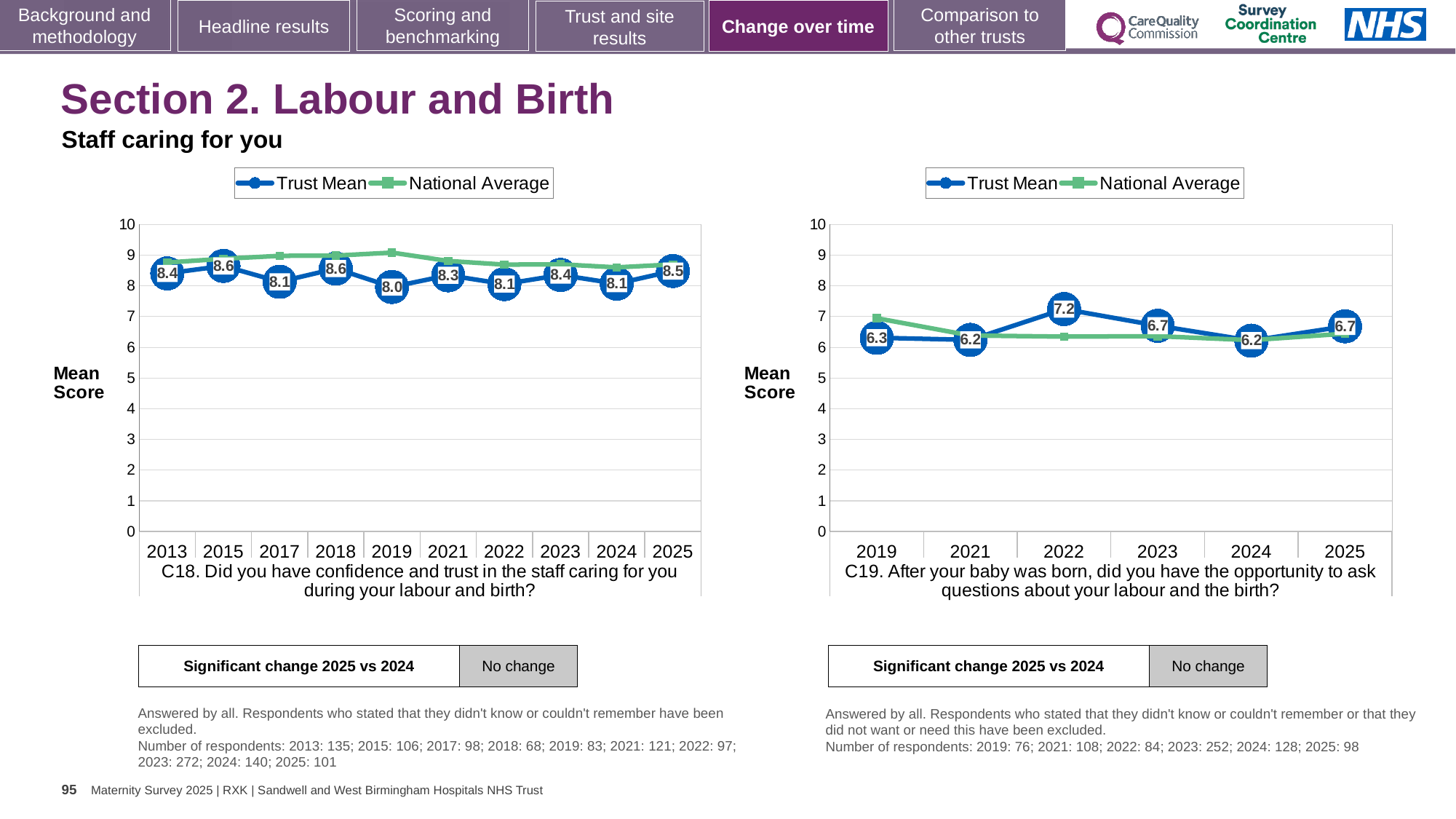
What kind of chart is the C19 chart on the right? Line chart In the C19 chart on the right, how many series does the legend list? 2 In the C19 chart on the right, what is the Trust Mean score for 2022? 7.2 In the C18 chart on the left, what is the Trust Mean score for 2019? 8.0 In the C19 chart on the right, is the National Average value for 2019 greater or less than 6? greater In the C18 chart on the left, in 2019 which series is higher, Trust Mean or National Average? National Average In the C18 chart on the left, how many years are plotted on the x axis? 10 In the C19 chart on the right, which year has the highest Trust Mean score? 2022 In the C19 chart on the right, what is the difference between the Trust Mean scores for 2022 and 2021? 1.0 In the C18 chart on the left, what is the difference between the Trust Mean scores for 2025 and 2024? 0.4 In the C18 chart on the left, which year has the lowest Trust Mean score? 2019 In the C18 chart on the left, what is the Trust Mean score for 2025? 8.5